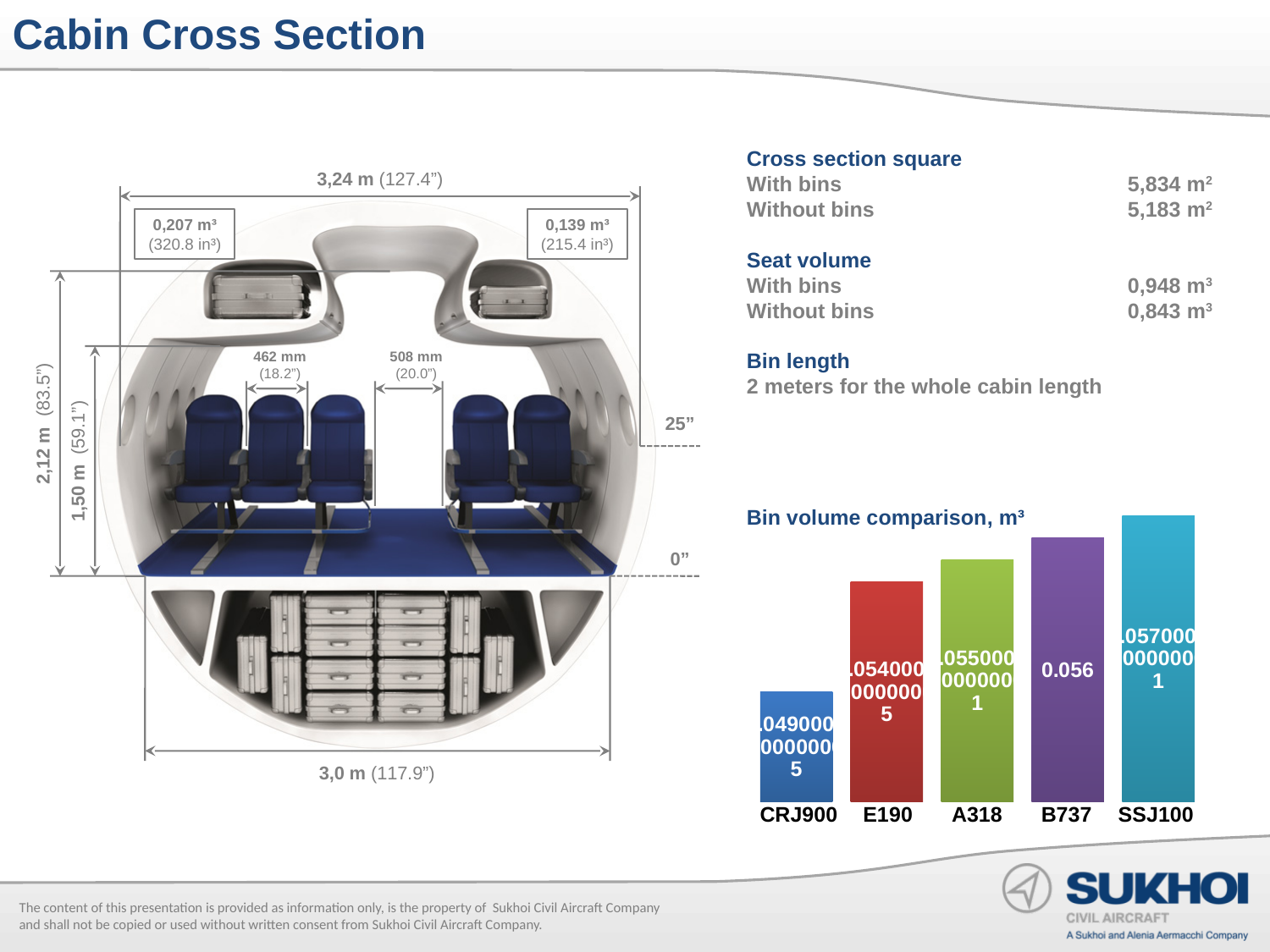
What kind of chart is the 'Bin volume comparison, m³' chart? bar chart On the 'Bin volume comparison, m³' chart, which has a larger bin volume, the CRJ900 or the SSJ100? SSJ100 On the 'Bin volume comparison, m³' chart, which has a larger bin volume, the E190 or the A318? A318 Do the bin volume values rise or fall from left to right across the 'Bin volume comparison, m³' chart? rise Which aircraft has the highest bin volume on the 'Bin volume comparison, m³' chart? SSJ100 How many aircraft types are shown on the 'Bin volume comparison, m³' chart? 5 What is the title of the bar chart on the slide? Bin volume comparison, m³ What is the bin volume value shown for the B737 on the 'Bin volume comparison, m³' chart? 0.056 On the 'Bin volume comparison, m³' chart, which has a larger bin volume, the B737 or the E190? B737 Which aircraft is listed first (leftmost) on the 'Bin volume comparison, m³' chart? CRJ900 Which aircraft has the lowest bin volume on the 'Bin volume comparison, m³' chart? CRJ900